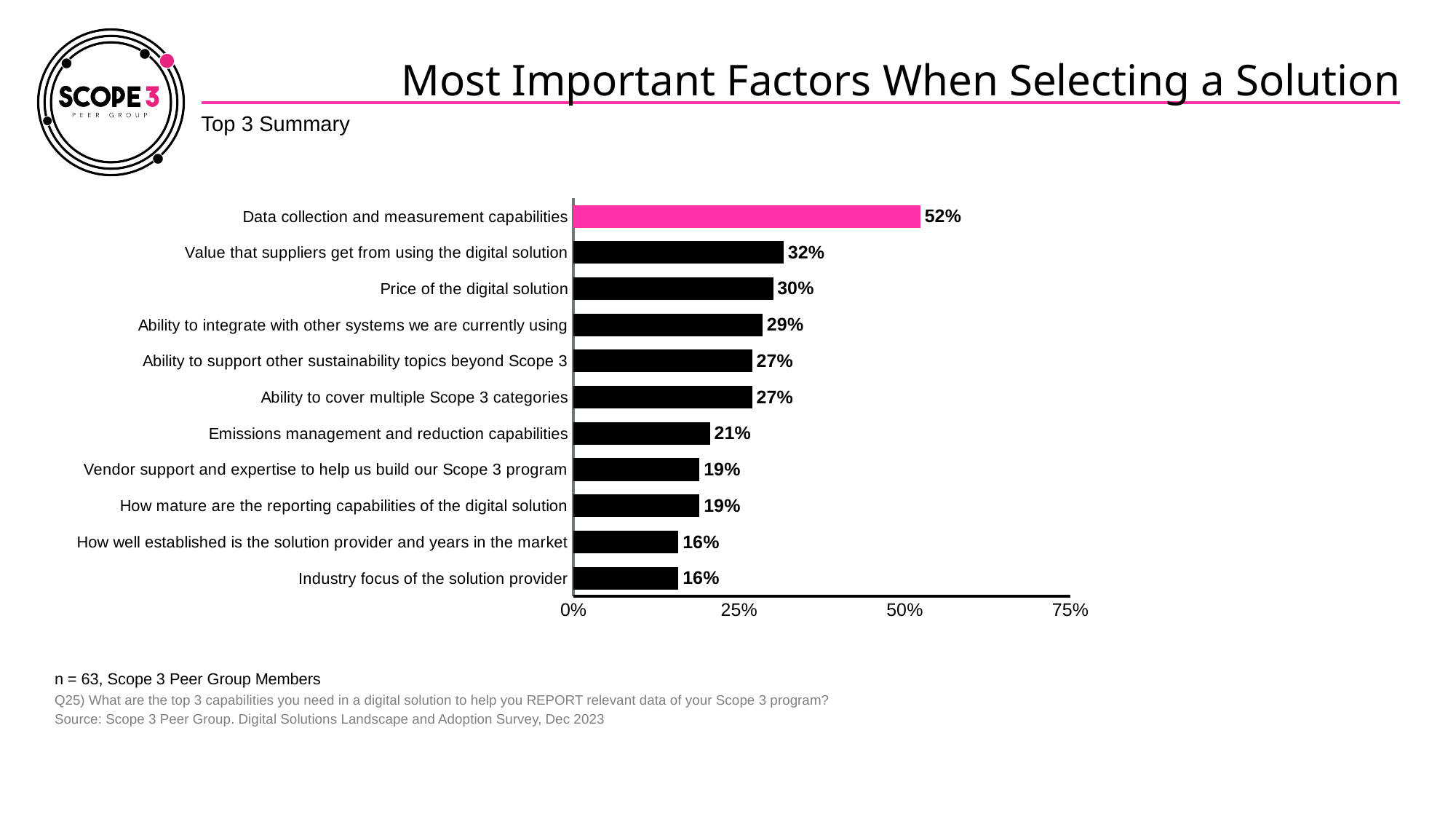
What percentage is shown for 'Data collection and measurement capabilities'? 52% Is the value for 'Value that suppliers get from using the digital solution' greater or less than 25%? greater What percentage is shown for 'Emissions management and reduction capabilities'? 21% Is the value for 'Industry focus of the solution provider' greater or less than 25%? less Which factor has the highest percentage? Data collection and measurement capabilities What is the value for 'Price of the digital solution'? 30% How many factors are listed in the chart? 11 Which bar is highlighted in pink rather than black? Data collection and measurement capabilities What is the difference between 'Ability to integrate with other systems we are currently using' and 'Vendor support and expertise to help us build our Scope 3 program'? 10% What is the difference between 'Data collection and measurement capabilities' and 'Value that suppliers get from using the digital solution'? 20% Which is larger: 'Price of the digital solution' or 'Ability to cover multiple Scope 3 categories'? Price of the digital solution What type of chart is shown on the slide? Bar chart